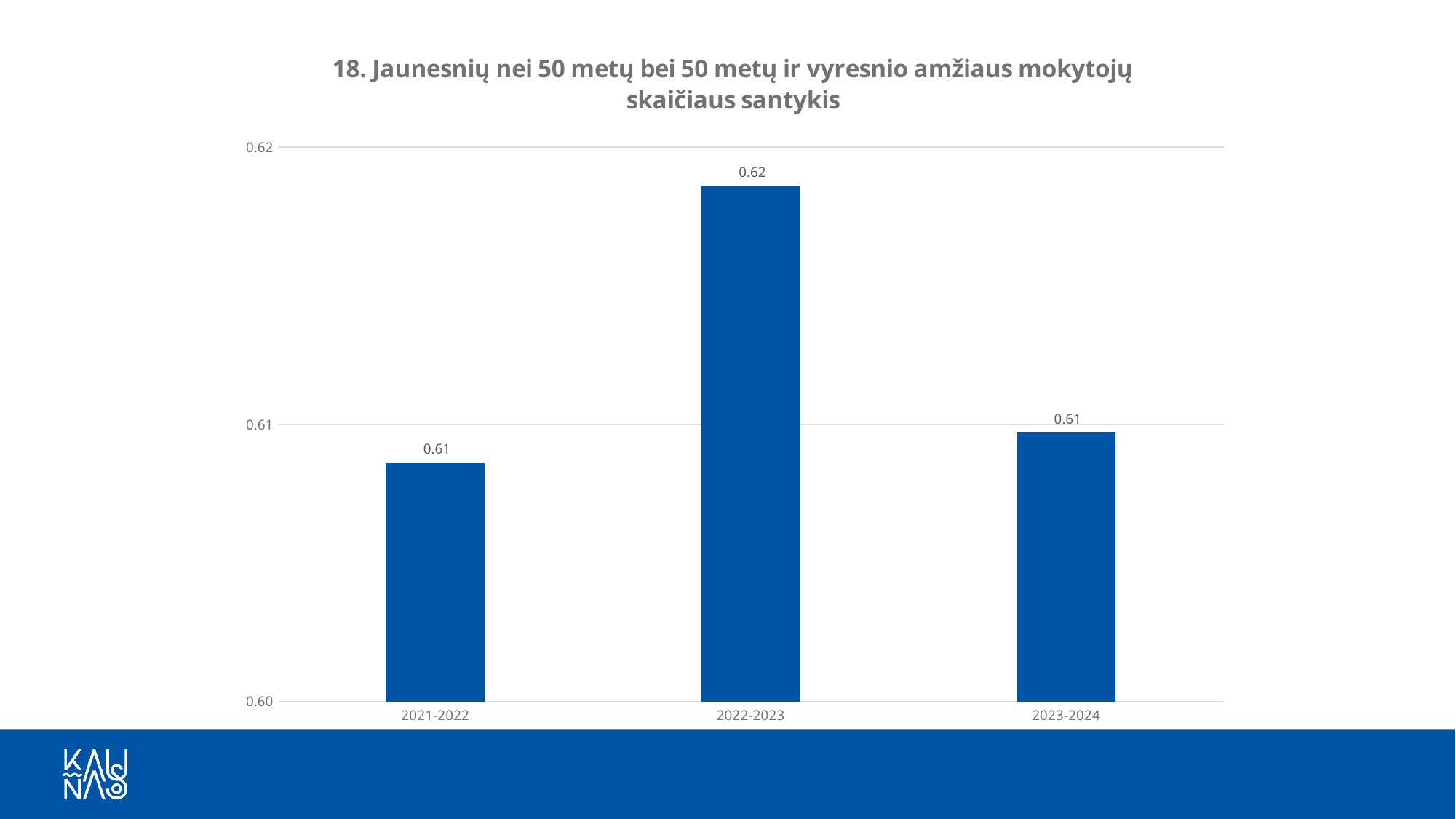
What is the value for 2021-2022? 0.61 What is the highest value shown on the y axis? 0.62 What is the value for 2022-2023? 0.62 Does the value rise or fall from 2022-2023 to 2023-2024? fall Is the value for 2022-2023 greater or less than 0.61? greater What is the difference between the values for 2022-2023 and 2021-2022? 0.01 What is the value for 2023-2024? 0.61 What kind of chart is shown on the slide? bar chart Which is larger, the value for 2022-2023 or the value for 2023-2024? 2022-2023 Which school year has the highest value? 2022-2023 What colour are the bars in the chart? blue How many school years are shown on the x axis? 3